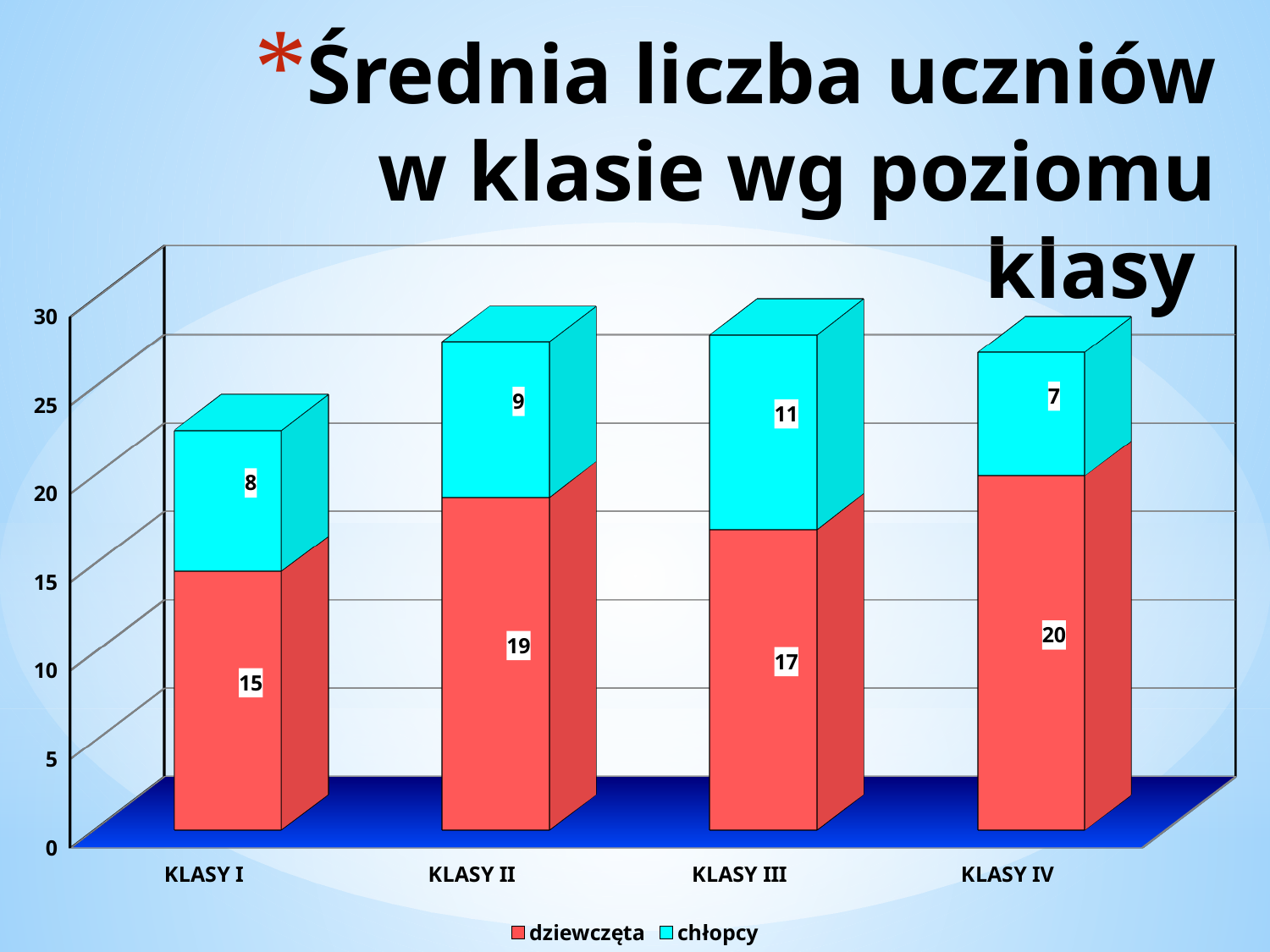
What is the value for chłopcy in KLASY III? 11 Which class has the highest value for dziewczęta? KLASY IV What kind of chart is shown on the slide? Stacked bar chart Which is larger, the chłopcy value for KLASY II or for KLASY III? KLASY III What is the difference between the dziewczęta values for KLASY IV and KLASY I? 5 What is the total of the stacked bar for KLASY I? 23 Which class has the lowest value for chłopcy? KLASY IV How many classes are shown on the x axis? 4 What is the total of the stacked bar for KLASY III? 28 What is the value for dziewczęta in KLASY II? 19 What is the value for dziewczęta in KLASY IV? 20 How many series does the legend list? 2